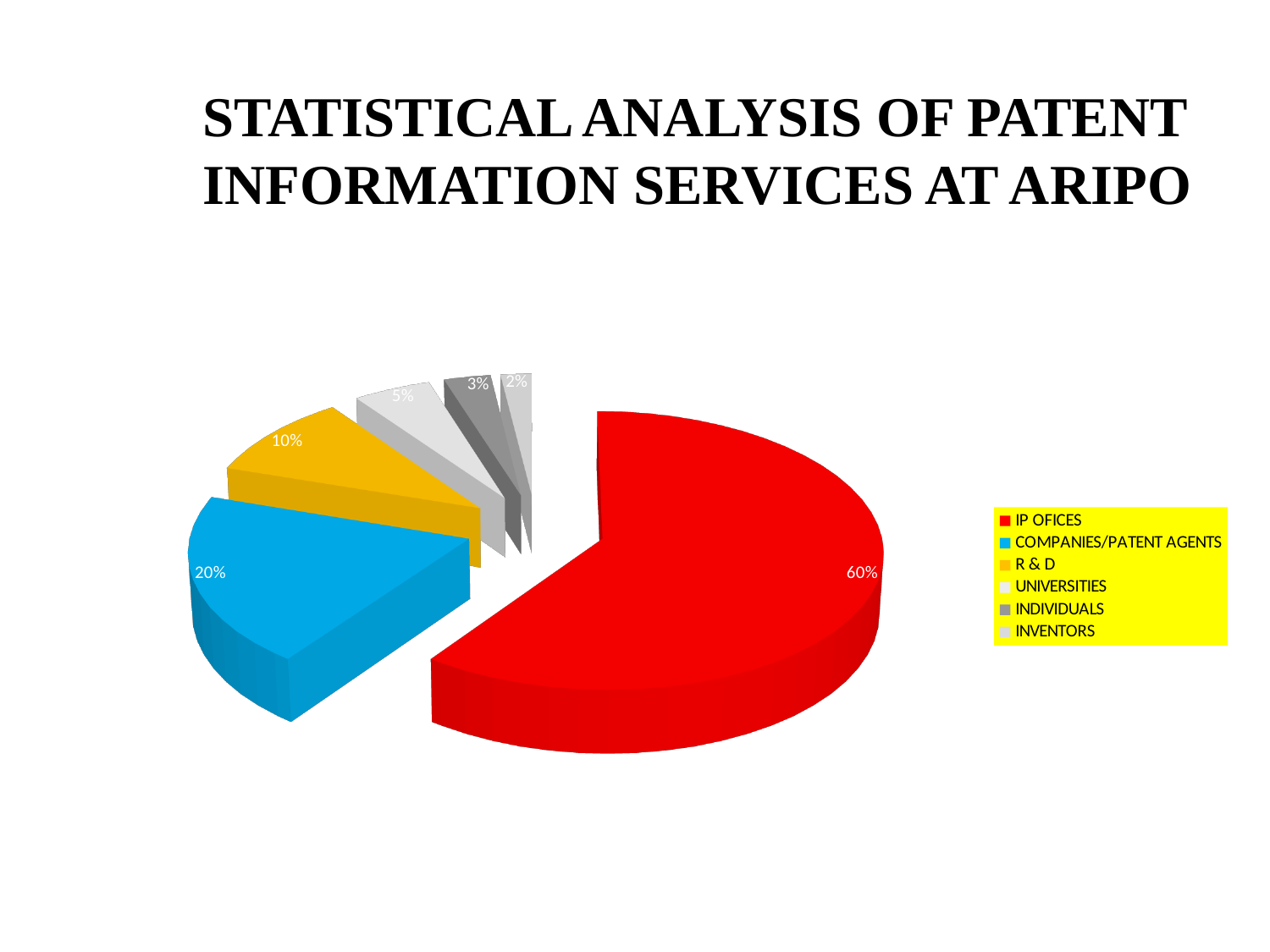
What share of the pie does IP OFICES hold? 60% Which category has the smallest slice of the pie? INVENTORS Which is larger, the share for R & D or the share for UNIVERSITIES? R & D What colour is the slice for COMPANIES/PATENT AGENTS? Blue What share of the pie does INDIVIDUALS hold? 3% What share of the pie does COMPANIES/PATENT AGENTS hold? 20% What share of the pie does UNIVERSITIES hold? 5% How many categories does the legend list? 6 What share of the pie does R & D hold? 10% What kind of chart is shown on the slide? Pie chart Which category has the largest slice of the pie? IP OFICES What is the difference between the shares of IP OFICES and COMPANIES/PATENT AGENTS? 40%